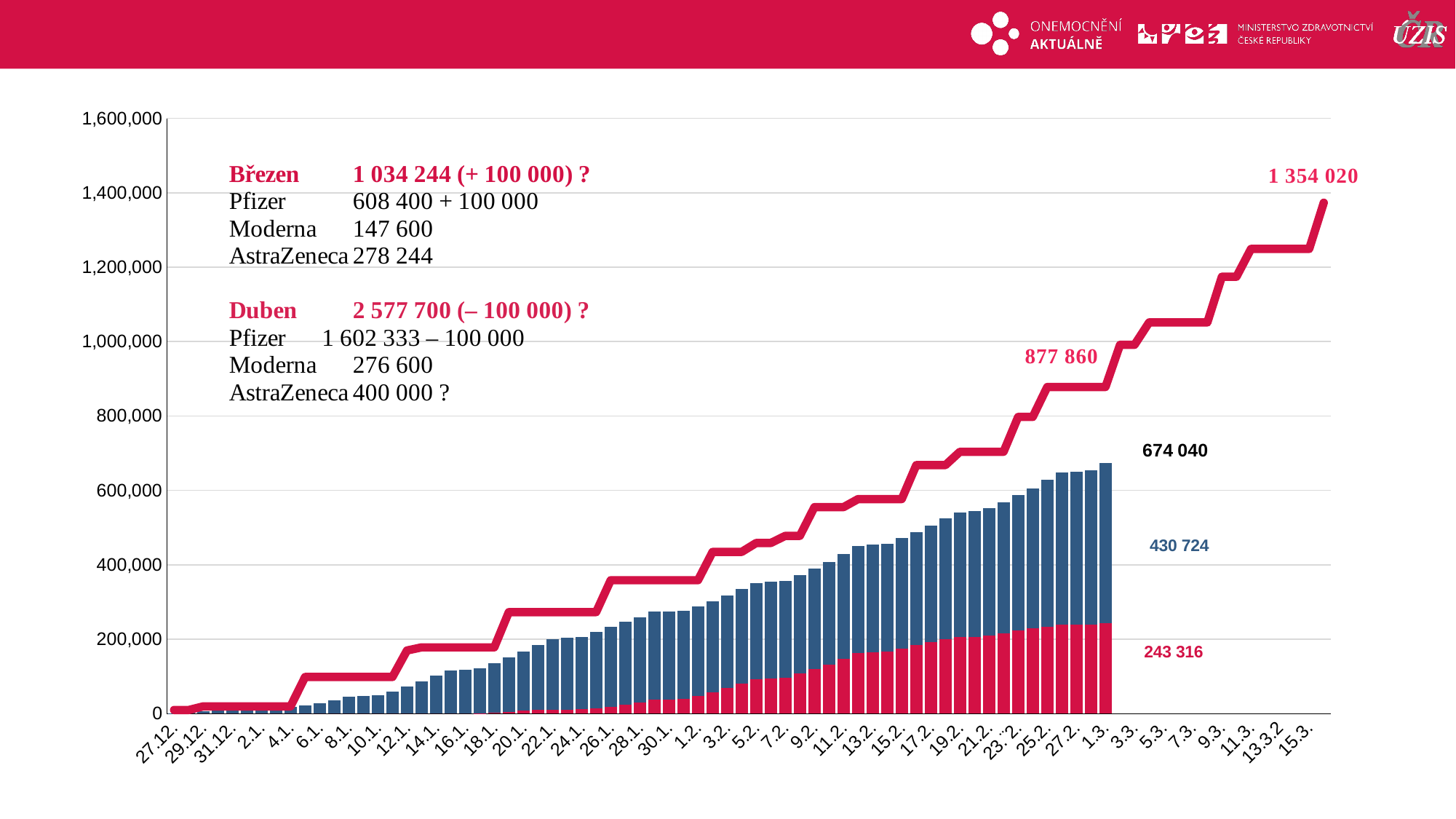
What is the difference between the blue segment (430 724) and the red segment (243 316) of the last stacked bar? 187 408 What is the value labelled for the red segment of the last stacked bar? 243 316 What is the value labelled for the blue segment of the last stacked bar? 430 724 In the last stacked bar, which segment is larger, the blue one or the red one? blue What kind of chart is shown on the slide? stacked bar chart combined with a line chart How much higher is the final red line value (1 354 020) than the last stacked bar total (674 040)? 679 980 What is the second-highest value labelled on the red line? 877 860 What is the total labelled for the last stacked bar (1.3.)? 674 040 What is the value labelled at the final point of the red line? 1 354 020 Is the total of the stacked bar at 1.2. greater or less than 400,000? less Is the value of the red line at 15.3. greater or less than 1,200,000? greater Does the red line rise or fall from left to right along the x axis? rise